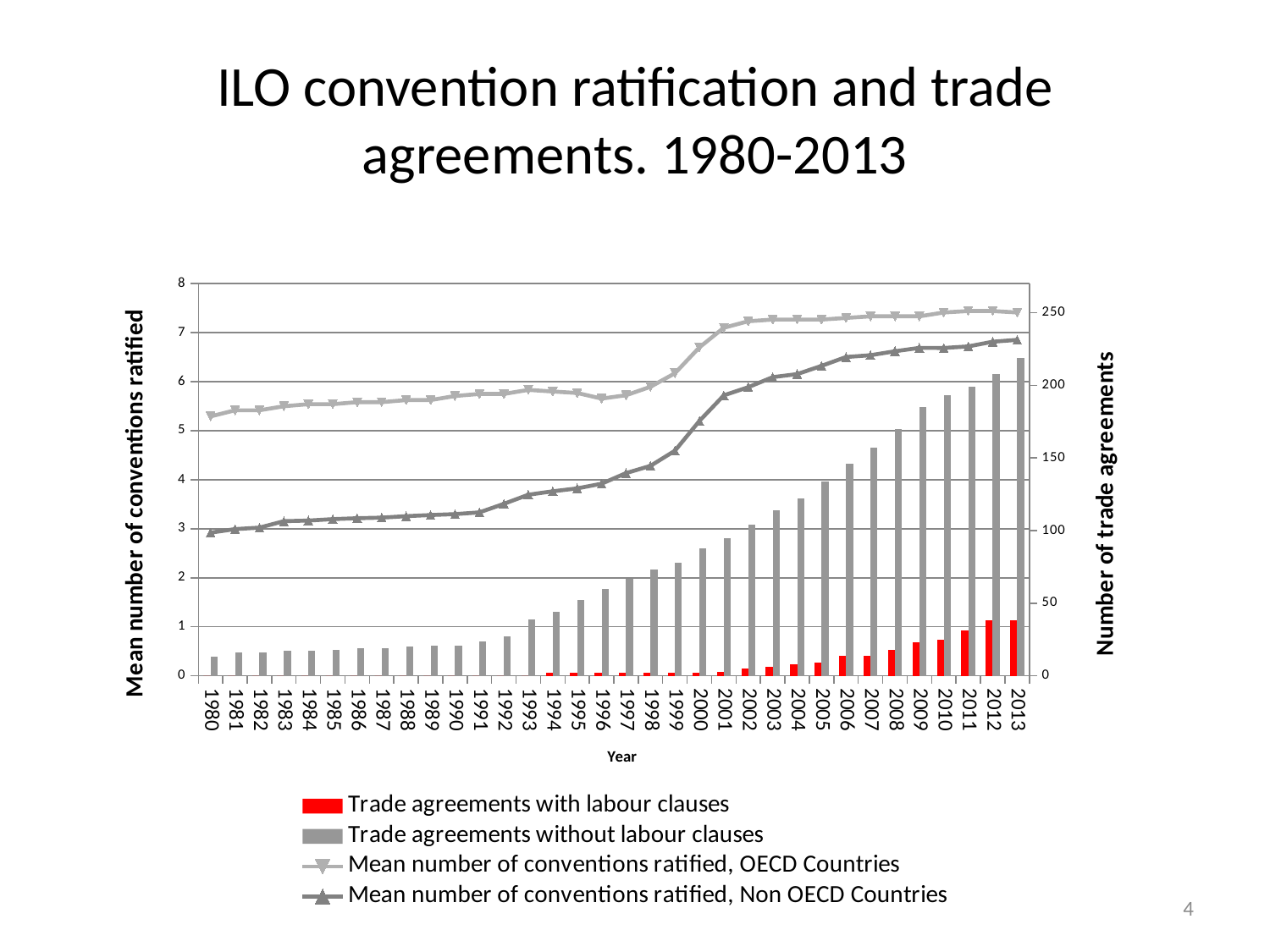
What is the title of the right-hand vertical axis? Number of trade agreements Is the mean number of conventions ratified by Non OECD countries in 2013 greater or less than 6? greater In 2013, which is higher: the mean number of conventions ratified by OECD countries or by Non OECD countries? OECD Countries What kind of chart is shown on the slide? A combined bar and line chart Which year has the highest number of trade agreements without labour clauses? 2013 Does the mean number of conventions ratified by OECD countries rise or fall from 1980 to 2013? Rise Is the number of trade agreements without labour clauses in 2013 greater or less than 200? greater Is the number of trade agreements with labour clauses in 2013 greater or less than 50? less What colour are the bars for trade agreements with labour clauses? Red How many series does the legend list? 4 Which year has the lowest number of trade agreements without labour clauses? 1980 How many years are shown on the x axis? 34